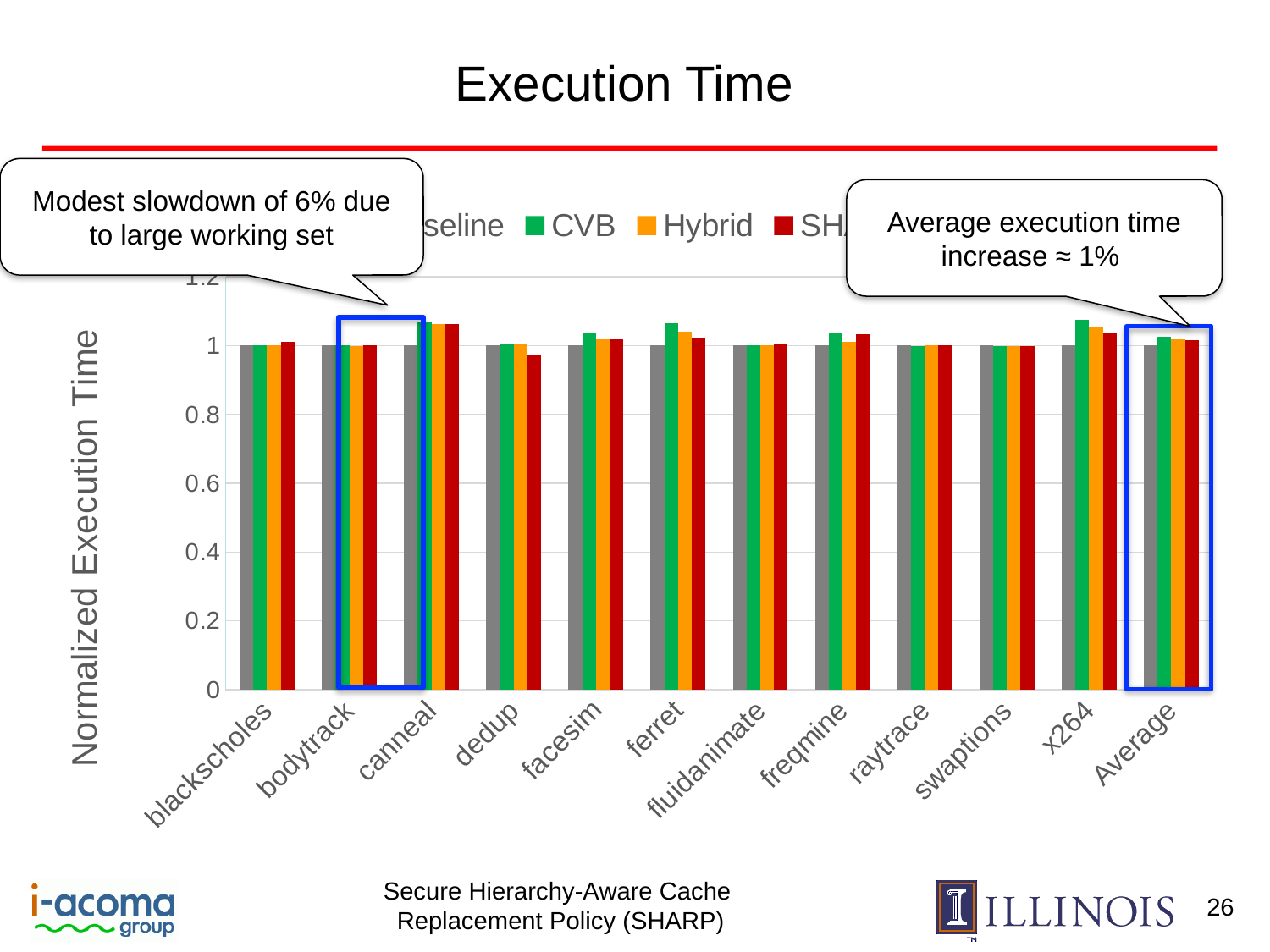
Which is larger, the Hybrid value for x264 or the Hybrid value for raytrace? x264 How many categories are shown along the x axis of the chart? 12 What kind of chart is shown on the slide? bar chart What is the label on the y axis of the chart? Normalized Execution Time Is the CVB value for dedup greater or less than 1.2? less What is the last category labelled on the x axis of the chart? Average Is the CVB value for x264 greater or less than 1? greater Is the Hybrid value for x264 greater or less than 1? greater How many series does the chart's legend list? 4 Which is larger, the CVB value for canneal or the CVB value for blackscholes? canneal